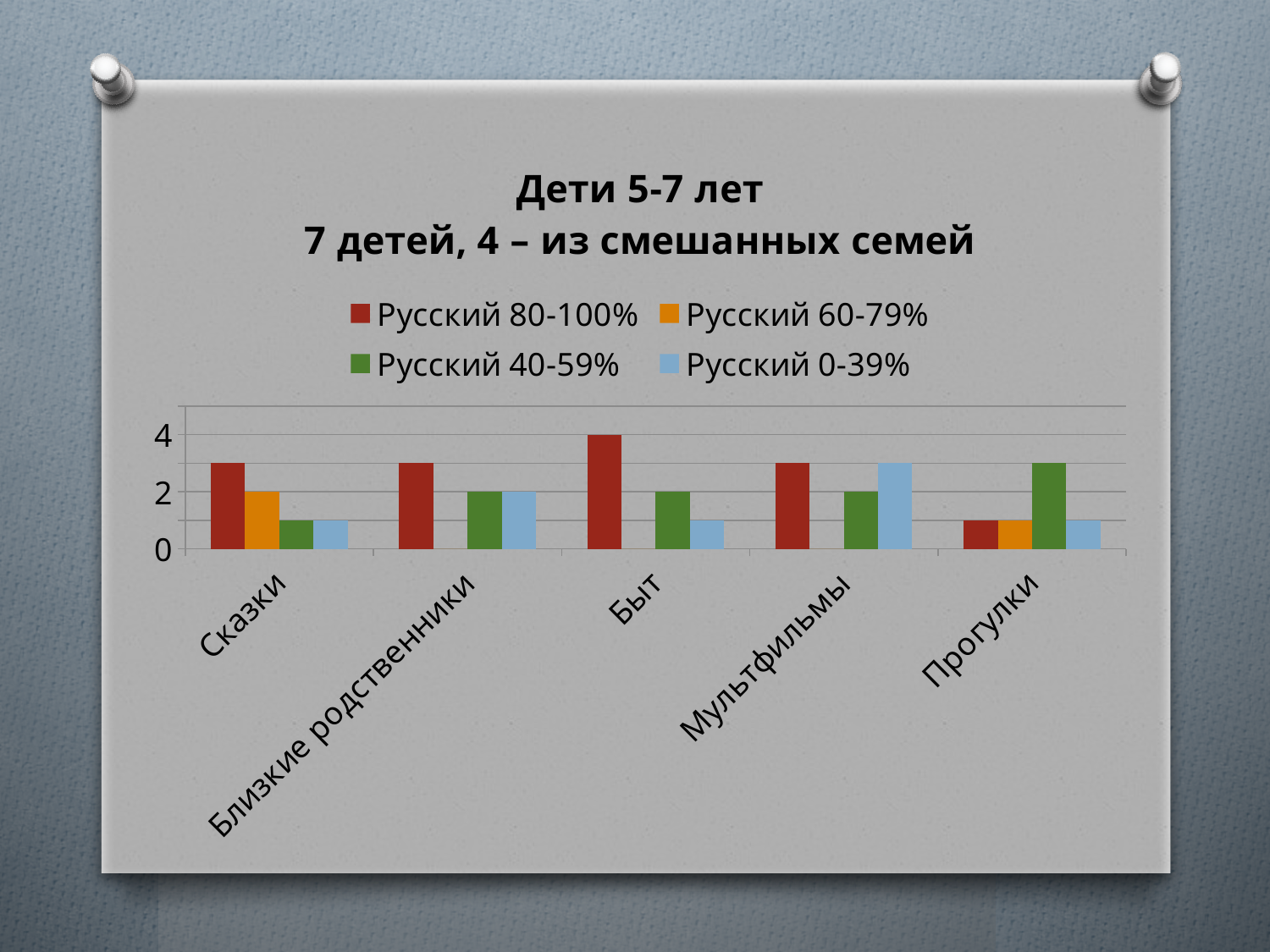
Is the value for Русский 0-39% in the Мультфильмы category greater or less than 2? greater What is the value for Русский 80-100% in the Быт category? 4 How many series does the legend list? 4 Which colour represents the Русский 0-39% series in the legend? light blue In the Прогулки category, which is larger: Русский 40-59% or Русский 80-100%? Русский 40-59% Is the value for Русский 80-100% in the Сказки category greater or less than 2? greater What is the value for Русский 60-79% in the Сказки category? 2 How many categories are shown along the x axis? 5 In which category is the Русский 80-100% series highest? Быт What kind of chart is shown on the slide? bar chart What is the value for Русский 40-59% in the Близкие родственники category? 2 In which category is the Русский 80-100% series lowest? Прогулки